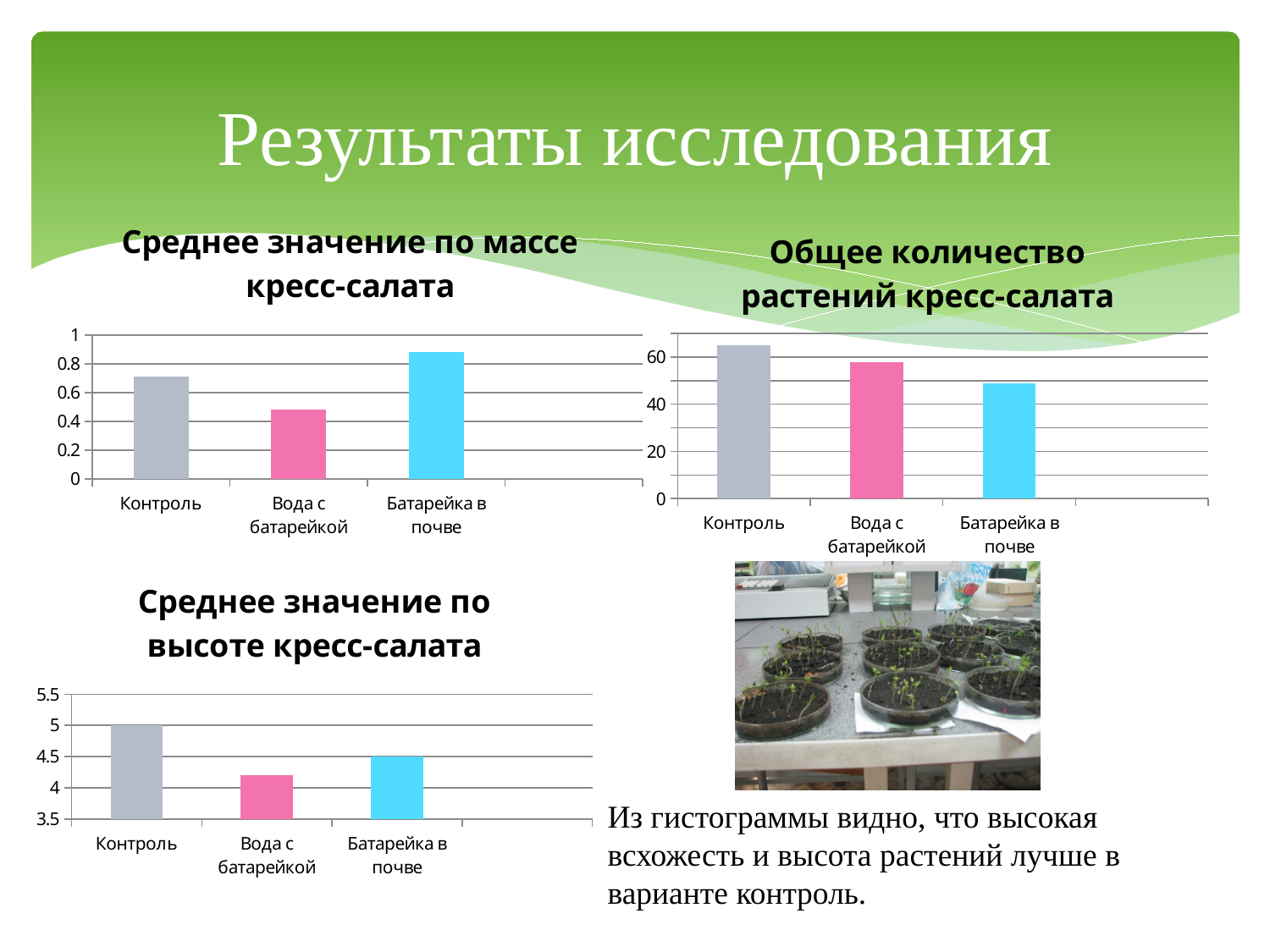
In the chart 'Среднее значение по массе кресс-салата', is the value for Вода с батарейкой greater or less than 0.6? less In the chart 'Среднее значение по высоте кресс-салата', which category has the lowest value? Вода с батарейкой In the chart 'Среднее значение по массе кресс-салата', which category has the highest value? Батарейка в почве In the chart 'Среднее значение по высоте кресс-салата', what is the value for Контроль? 5 In the chart 'Общее количество растений кресс-салата', which is larger: Вода с батарейкой or Батарейка в почве? Вода с батарейкой In the chart 'Общее количество растений кресс-салата', which category has the highest value? Контроль In the chart 'Общее количество растений кресс-салата', which category has the lowest value? Батарейка в почве In the chart 'Общее количество растений кресс-салата', is the value for Контроль greater or less than 60? greater In the chart 'Среднее значение по массе кресс-салата', which category has the lowest value? Вода с батарейкой How many categories are shown in the chart 'Среднее значение по высоте кресс-салата'? 3 In the chart 'Среднее значение по массе кресс-салата', is the value for Батарейка в почве greater or less than 0.8? greater What type of chart is 'Общее количество растений кресс-салата'? bar chart